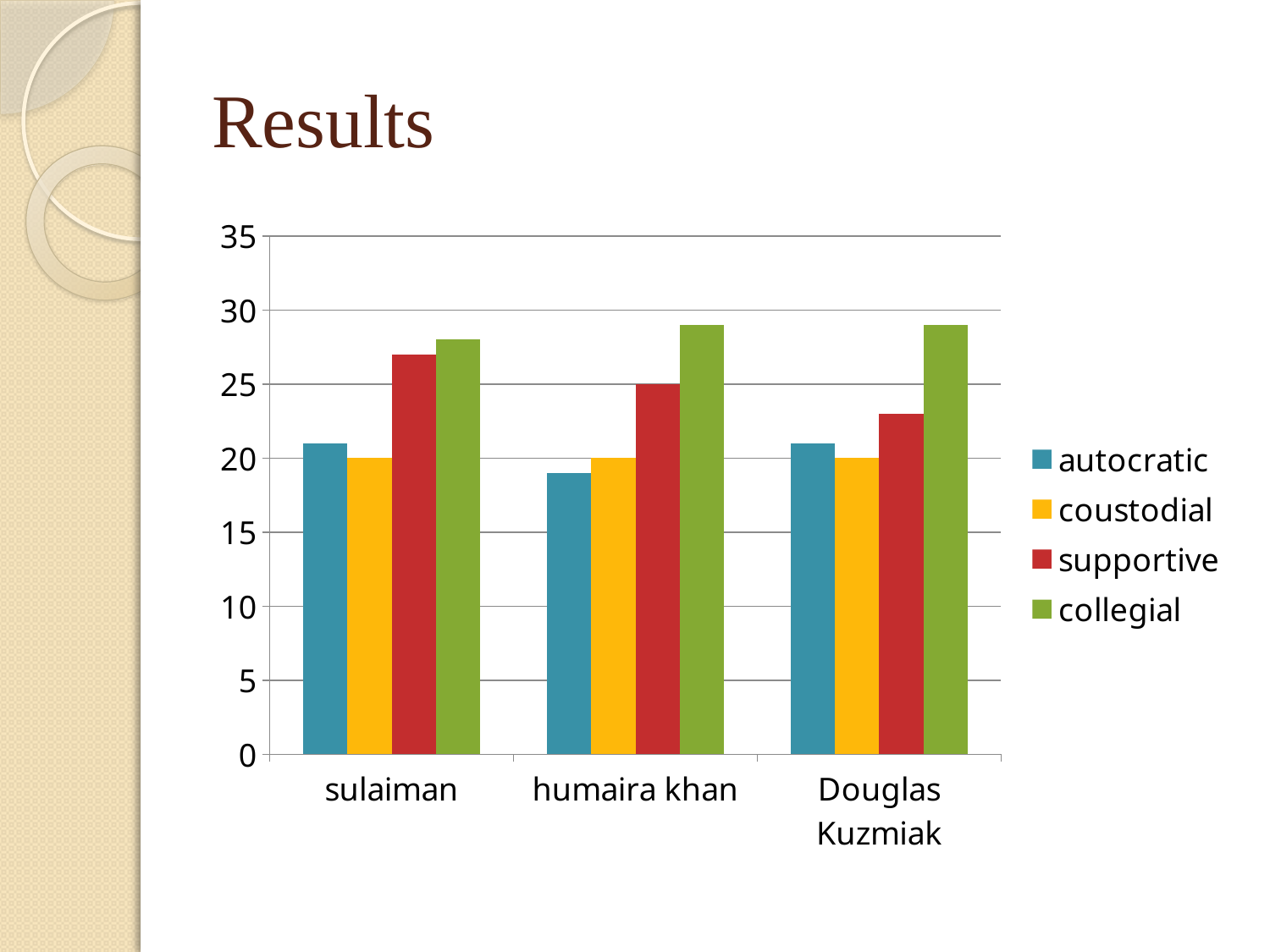
Which series has the lowest value for humaira khan? autocratic What is the supportive value for humaira khan? 25 Is the collegial value for humaira khan greater or less than 25? greater What kind of chart is shown on the slide? bar chart What is the coustodial value for Douglas Kuzmiak? 20 Which series has the highest value for humaira khan? collegial Which is larger, the supportive value for sulaiman or the supportive value for Douglas Kuzmiak? sulaiman How many series does the legend list? 4 What is the coustodial value for sulaiman? 20 Is the supportive value for Douglas Kuzmiak greater or less than 25? less Is the autocratic value for humaira khan greater or less than 20? less How many categories are shown on the x axis? 3